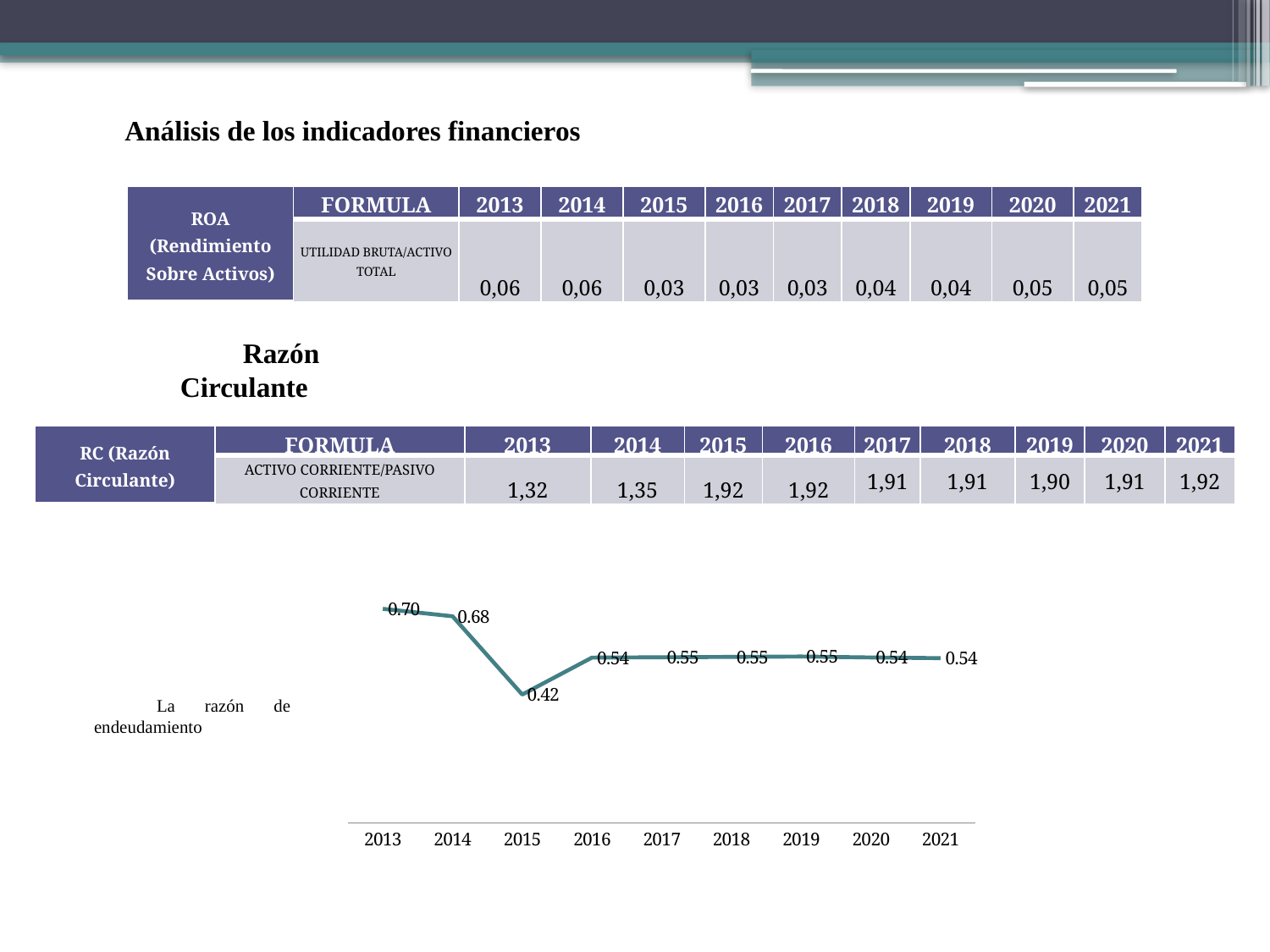
What type of chart is shown at the bottom of the slide? line chart In the line chart, what is the difference between the values for 2013 and 2015? 0.28 In the line chart, what is the value for 2017? 0.55 In the line chart, what is the difference between the values for 2014 and 2016? 0.14 In the line chart, which year has the highest value? 2013 How many years are plotted on the x axis of the line chart? 9 In the line chart, what is the value for 2015? 0.42 In the line chart, what is the value for 2013? 0.70 In the line chart, which is larger, the value for 2014 or the value for 2016? 2014 In the line chart, does the value rise or fall from 2013 to 2015? fall In the line chart, which year has the lowest value? 2015 In the line chart, what is the value for 2021? 0.54